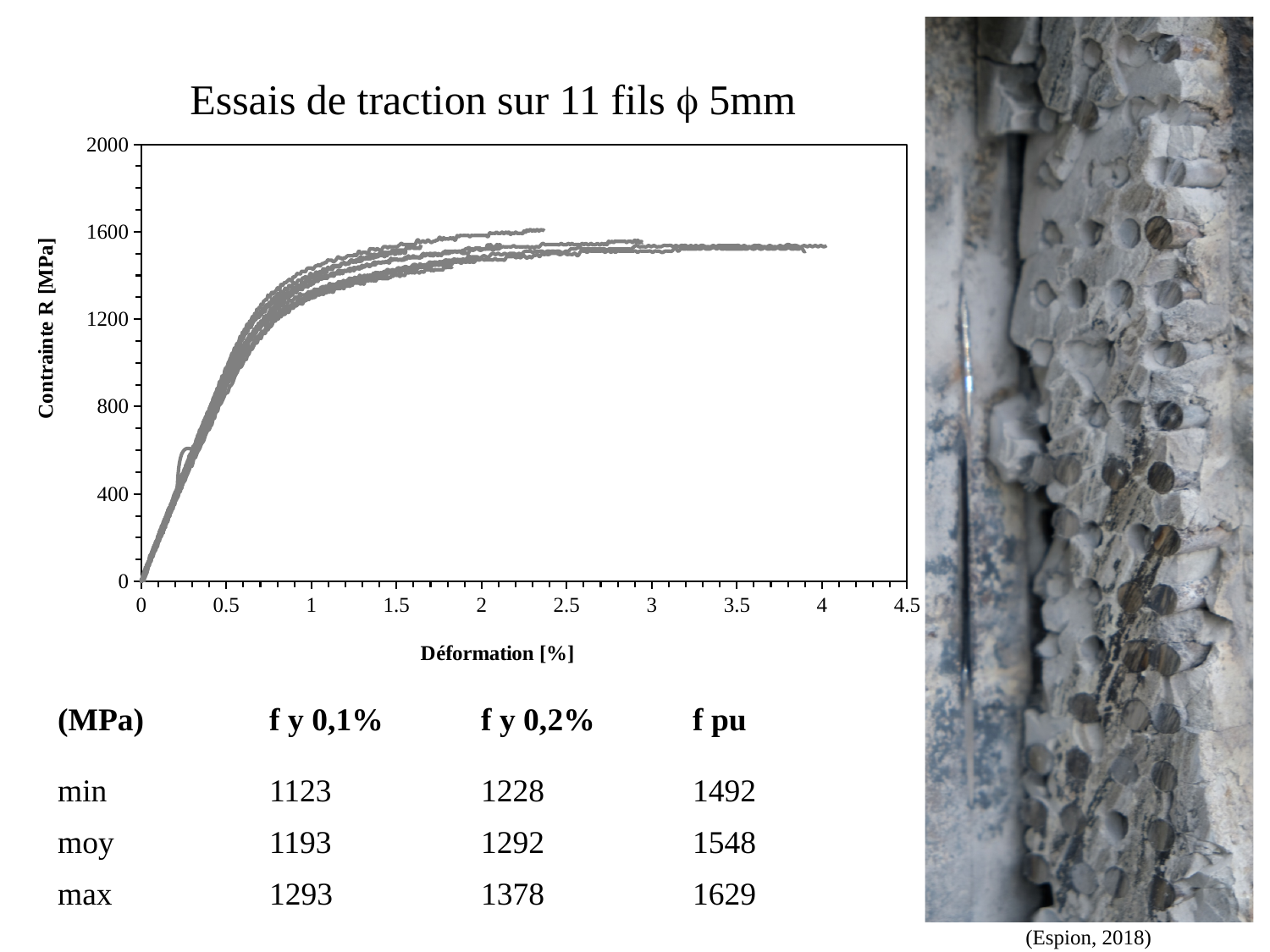
According to the chart title, how many wires were tested? 11 What kind of chart is shown on the slide? line chart Is the highest stress reached by any curve on the chart greater or less than 1200 MPa? greater What is the maximum value shown on the vertical axis of the chart? 2000 At a strain of 0.25%, is the stress on the curves greater or less than 800 MPa? less Is the largest strain reached by any curve on the chart greater or less than 3.5%? greater What is the maximum value shown on the horizontal axis of the chart? 4.5 What is the label of the vertical axis of the chart? Contrainte R [MPa] What is the title of the chart? Essais de traction sur 11 fils φ 5mm Do the curves on the chart rise or fall as strain increases from 0 to 1%? rise